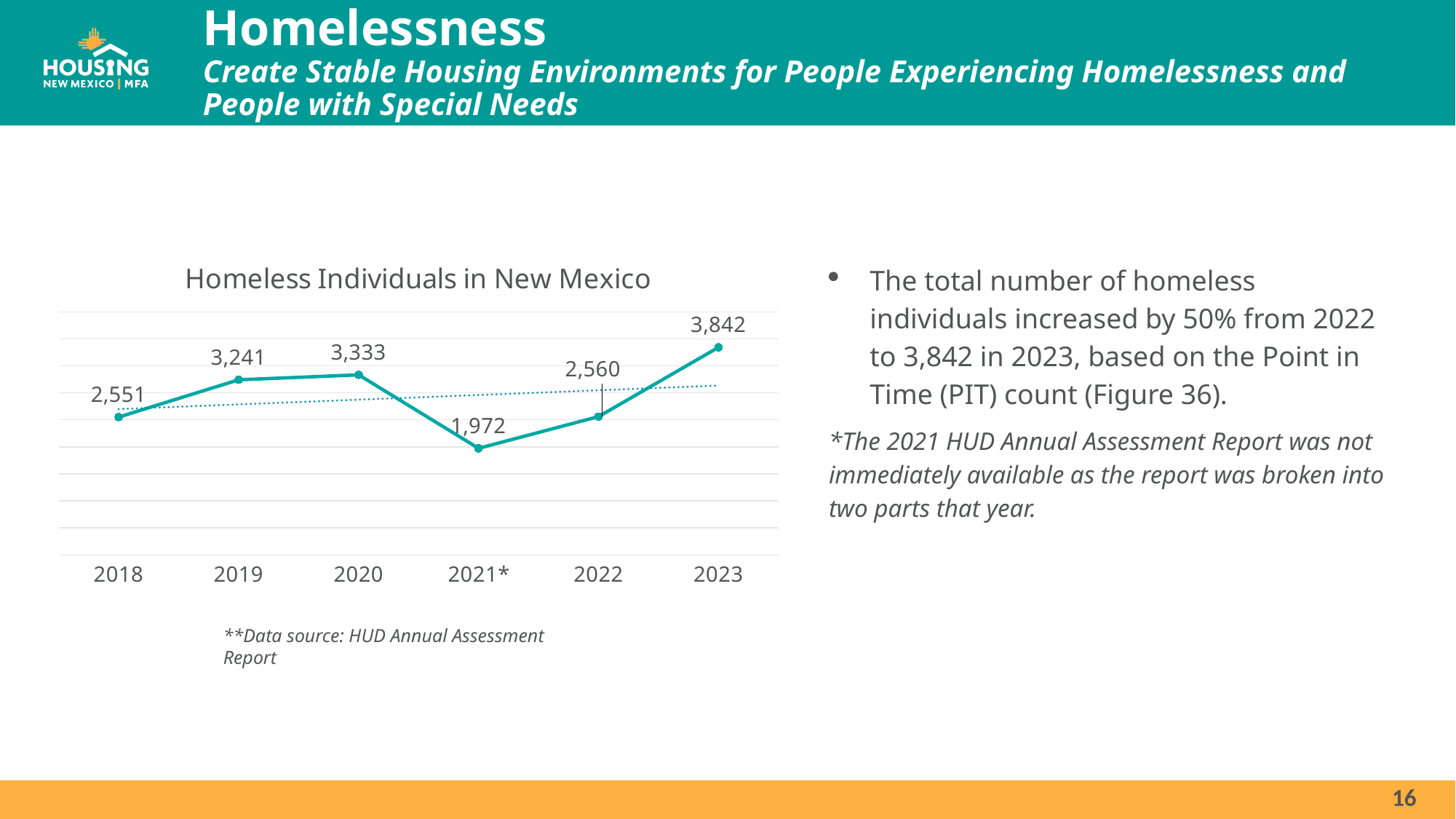
Which year has the highest number of homeless individuals? 2023 What is the title of the chart? Homeless Individuals in New Mexico What is the value for 2020 in the chart? 3,333 How many years are plotted on the x axis? 6 Did the number of homeless individuals rise or fall from 2020 to 2021*? fall What type of chart is shown on the slide? line chart How many homeless individuals were counted in New Mexico in 2018? 2,551 What is the difference between the 2020 value and the 2019 value? 92 Which year has the lowest number of homeless individuals? 2021* Which year has a larger value, 2019 or 2022? 2019 What is the value for 2021* in the chart? 1,972 What is the difference between the 2023 value and the 2022 value? 1,282